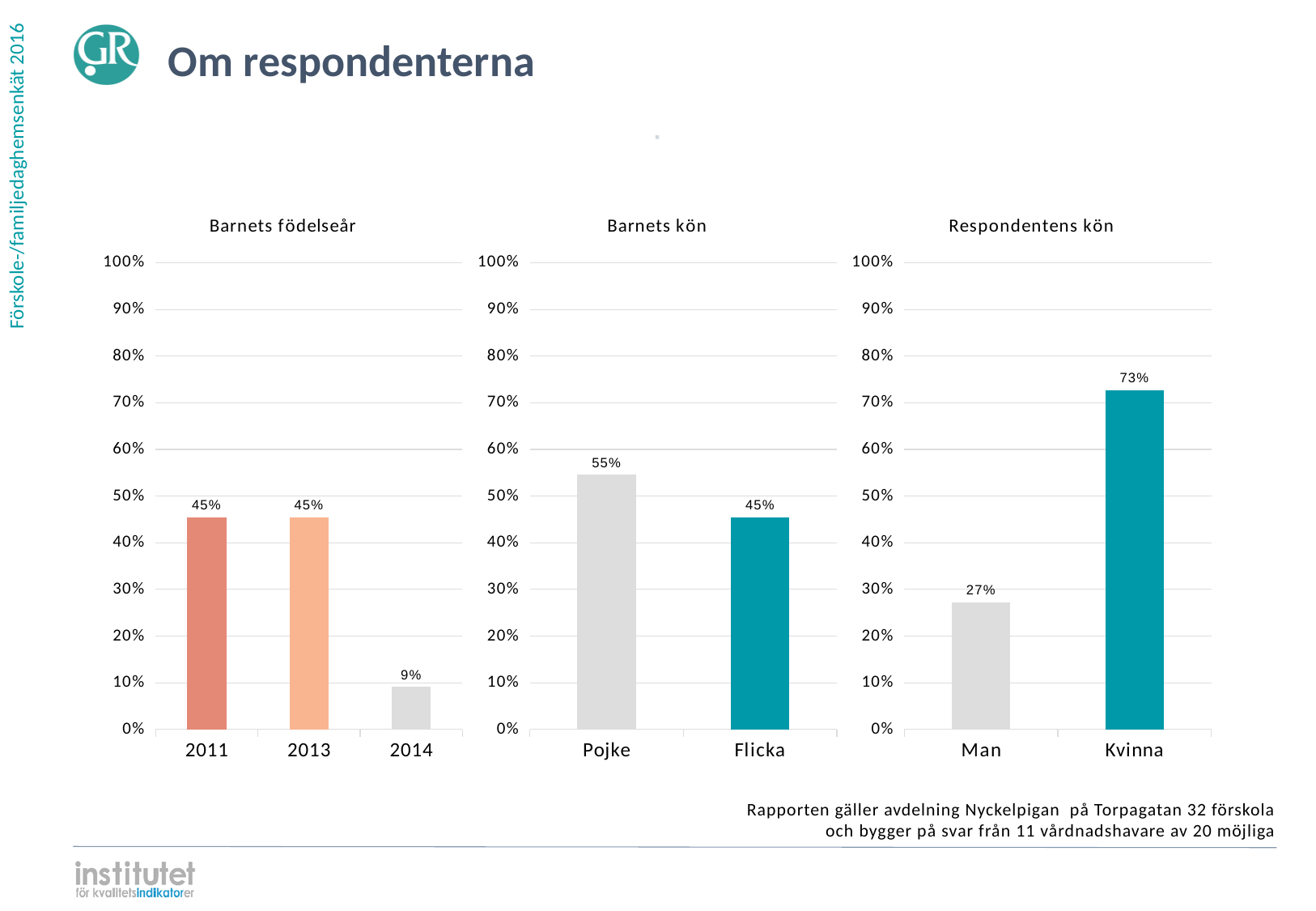
In the 'Barnets födelseår' chart, what is the value for 2014? 9% In the 'Barnets födelseår' chart, which category has the lowest value? 2014 In the 'Barnets kön' chart, which is larger, Pojke or Flicka? Pojke In the 'Barnets kön' chart, what is the difference between Pojke and Flicka? 10% What kind of chart is the 'Respondentens kön' chart? Bar chart In the 'Respondentens kön' chart, what is the value for Man? 27% In the 'Barnets födelseår' chart, what is the value for 2011? 45% In the 'Respondentens kön' chart, what is the value for Kvinna? 73% In the 'Barnets födelseår' chart, how many categories are shown on the x axis? 3 In the 'Respondentens kön' chart, which category has the highest value? Kvinna In the 'Respondentens kön' chart, what is the difference between Kvinna and Man? 46% In the 'Barnets kön' chart, what is the value for Pojke? 55%